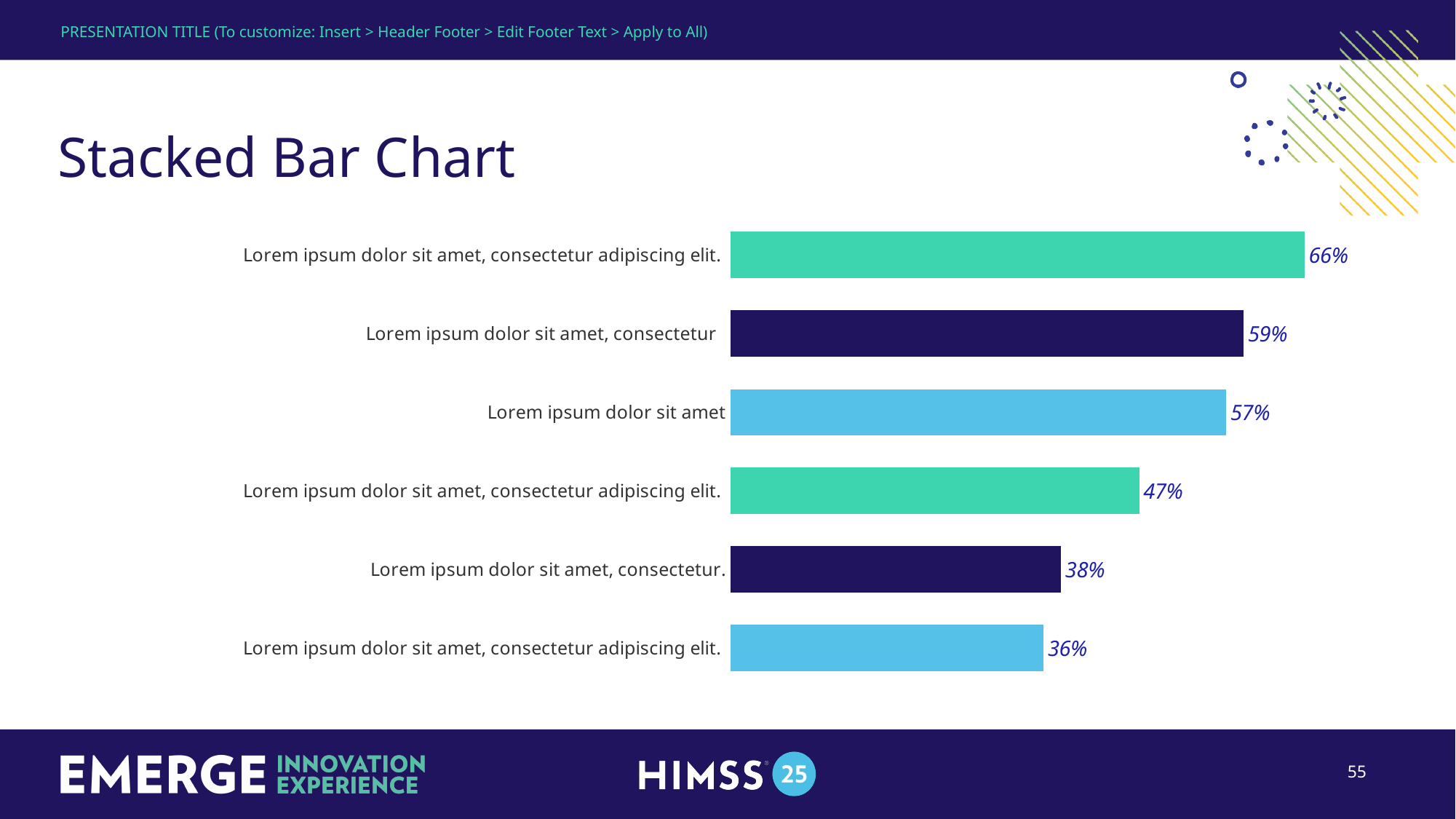
Do the bar values increase or decrease going from the top bar to the bottom bar? decrease What is the value of the bottom bar in the chart? 36% How many bars does the chart contain? 6 Which bar has the lowest value, and what is it? The bottom bar, 36% What is the title of the slide containing the chart? Stacked Bar Chart What is the value of the bar labelled "Lorem ipsum dolor sit amet" (the third bar from the top)? 57% Which bar has the highest value, and what is it? The top bar, 66% What kind of chart is shown on the slide? bar chart What is the value of the second bar from the top? 59% Which is larger: the fourth bar from the top (47%) or the fifth bar from the top (38%)? The fourth bar, 47% What is the value of the top bar in the chart? 66% What is the difference between the top bar (66%) and the bottom bar (36%)? 30%